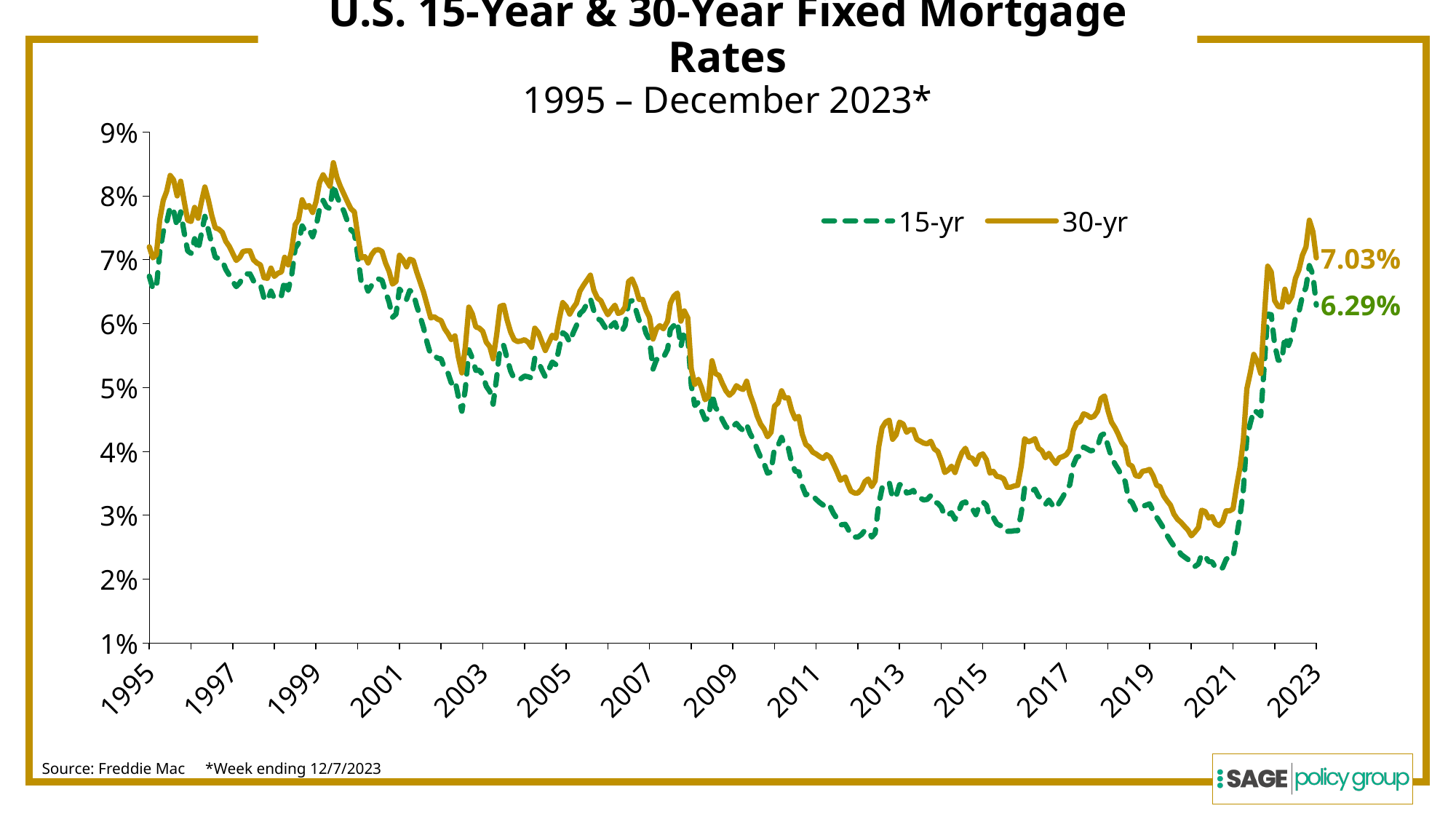
How many series does the legend list? 2 Is the 15-yr rate at the start of 1995 greater or less than 6%? greater Is the 30-yr rate in 2013 greater or less than 5%? less What kind of chart is shown on the slide? Line chart Which series has the higher latest value, 15-yr or 30-yr? 30-yr What is the latest value shown for the 15-yr mortgage rate? 6.29% Did mortgage rates generally rise or fall from 2021 to 2023? Rise What is the source cited for the chart data? Freddie Mac What is the difference between the latest 30-yr rate and the latest 15-yr rate? 0.74% What is the latest value shown for the 30-yr mortgage rate? 7.03% Is the 30-yr rate around 2021 greater or less than 4%? less Which series is drawn with a dashed line? 15-yr